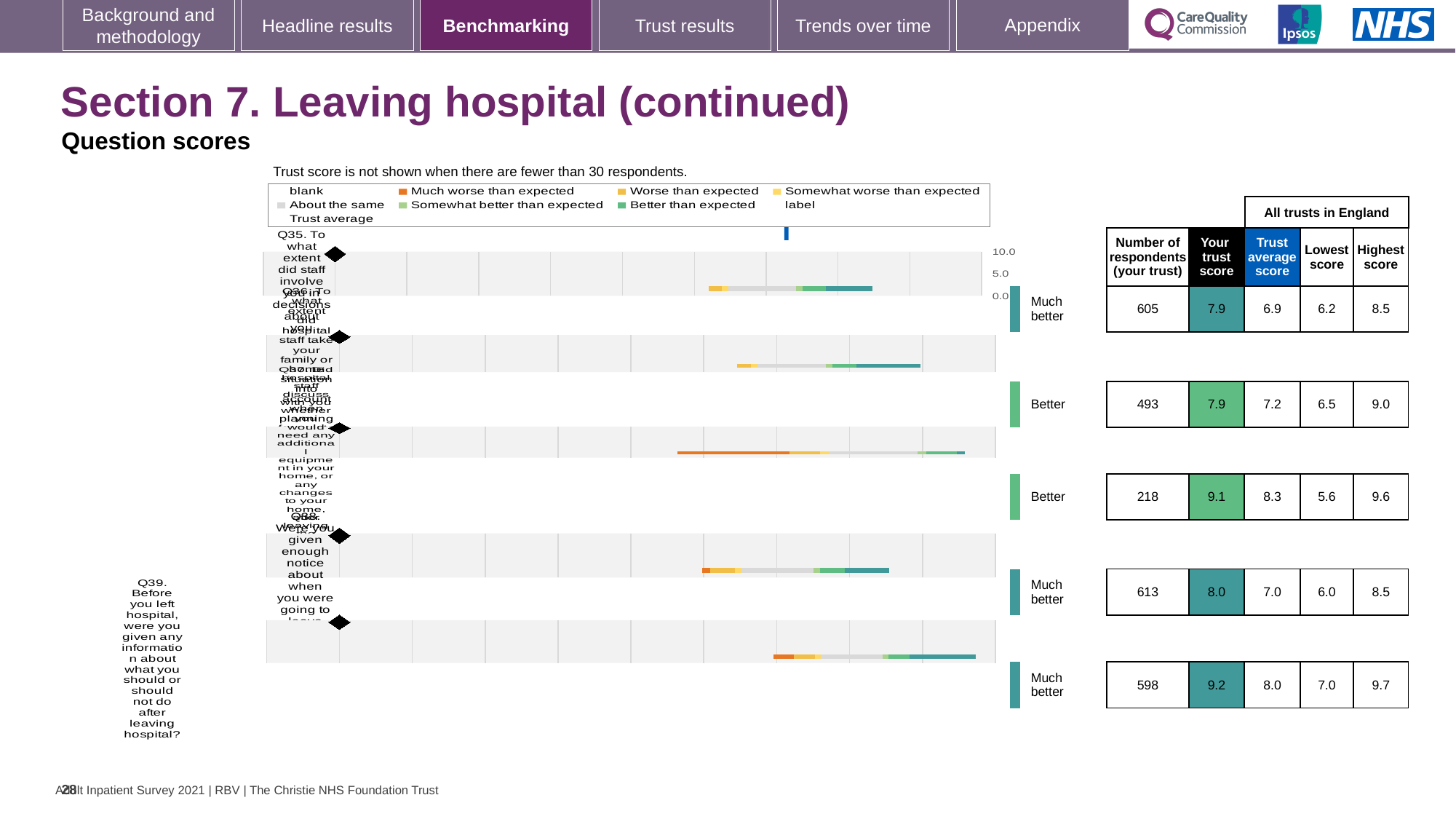
What is the number of respondents for the first (top) question row in the table? 605 What is your trust score for Q39? 9.2 What is the trust average score for Q39? 8.0 What is the highest score across all trusts in England for Q39? 9.7 Which question row has the highest 'Your trust score' in the table? Q39 For the top question row, which is larger: your trust score or the trust average score? Your trust score How many question rows are shown in the table on this slide? 5 What kind of chart is used to show the question scores on this slide? bar chart How many respondents from your trust answered Q39 (information about what you should or should not do after leaving hospital)? 598 What benchmark rating is shown next to Q39? Much better What is the difference between your trust score and the trust average score for Q39? 1.2 What is the lowest score across all trusts in England for the third question row (218 respondents)? 5.6